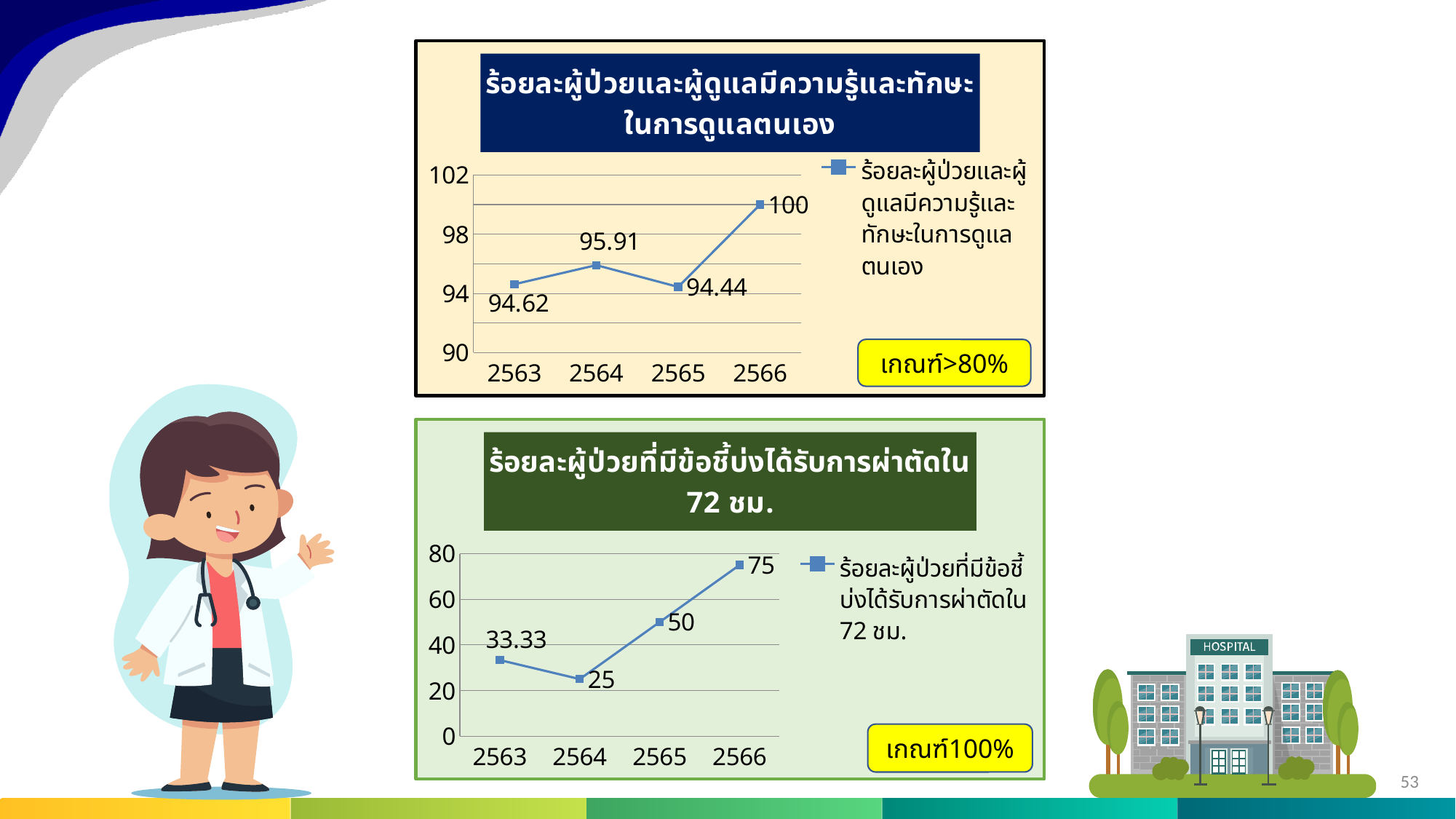
In the top chart (ร้อยละผู้ป่วยและผู้ดูแลมีความรู้และทักษะในการดูแลตนเอง), how many years are plotted on the x axis? 4 In the bottom chart (ร้อยละผู้ป่วยที่มีข้อชี้บ่งได้รับการผ่าตัดใน 72 ชม.), what is the difference between the values for 2566 and 2565? 25 In the bottom chart (ร้อยละผู้ป่วยที่มีข้อชี้บ่งได้รับการผ่าตัดใน 72 ชม.), do the values rise or fall from 2564 to 2566? Rise In the bottom chart (ร้อยละผู้ป่วยที่มีข้อชี้บ่งได้รับการผ่าตัดใน 72 ชม.), is the value for 2565 larger than the value for 2564? Yes In the bottom chart (ร้อยละผู้ป่วยที่มีข้อชี้บ่งได้รับการผ่าตัดใน 72 ชม.), what is the value for 2563? 33.33 In the bottom chart (ร้อยละผู้ป่วยที่มีข้อชี้บ่งได้รับการผ่าตัดใน 72 ชม.), which year has the highest value? 2566 In the top chart (ร้อยละผู้ป่วยและผู้ดูแลมีความรู้และทักษะในการดูแลตนเอง), which year has the lowest value? 2565 In the top chart (ร้อยละผู้ป่วยและผู้ดูแลมีความรู้และทักษะในการดูแลตนเอง), what is the difference between the values for 2566 and 2563? 5.38 In the bottom chart (ร้อยละผู้ป่วยที่มีข้อชี้บ่งได้รับการผ่าตัดใน 72 ชม.), which year has the lowest value? 2564 In the top chart (ร้อยละผู้ป่วยและผู้ดูแลมีความรู้และทักษะในการดูแลตนเอง), what is the value for 2564? 95.91 In the top chart (ร้อยละผู้ป่วยและผู้ดูแลมีความรู้และทักษะในการดูแลตนเอง), what is the value for 2566? 100 What kind of chart is the top chart (ร้อยละผู้ป่วยและผู้ดูแลมีความรู้และทักษะในการดูแลตนเอง)? Line chart